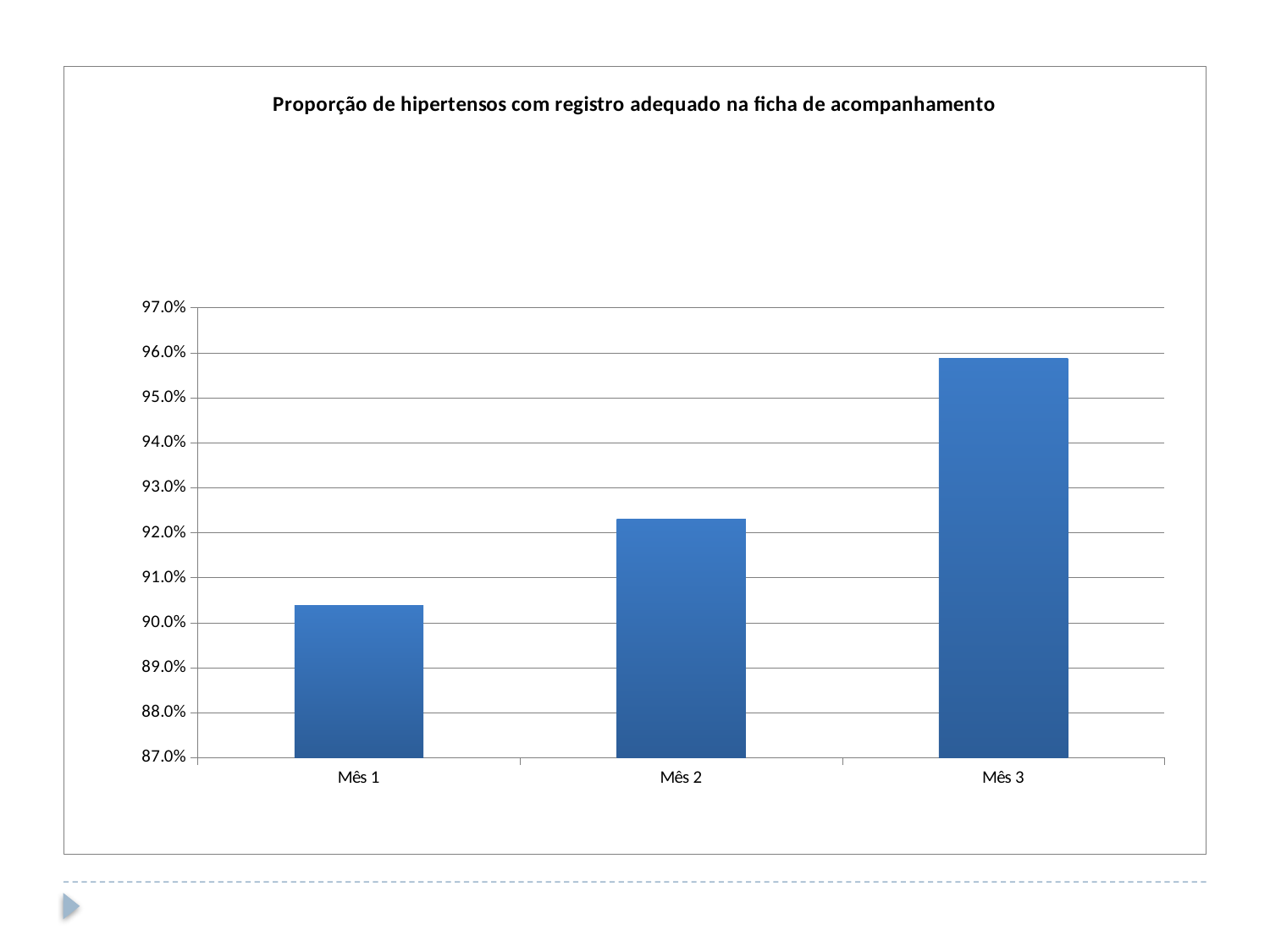
Which month has the lowest value? Mês 1 What kind of chart is shown on the slide? bar chart Which is larger, the value for Mês 1 or the value for Mês 2? Mês 2 Which is larger, the value for Mês 2 or the value for Mês 3? Mês 3 How many categories (months) are plotted on the chart? 3 Is the value for Mês 3 greater or less than 95.0%? greater Do the values rise or fall from Mês 1 to Mês 3? rise Is the value for Mês 2 greater or less than 93.0%? less Which month has the highest value? Mês 3 What is the title of the chart? Proporção de hipertensos com registro adequado na ficha de acompanhamento Is the value for Mês 2 greater or less than 92.0%? greater